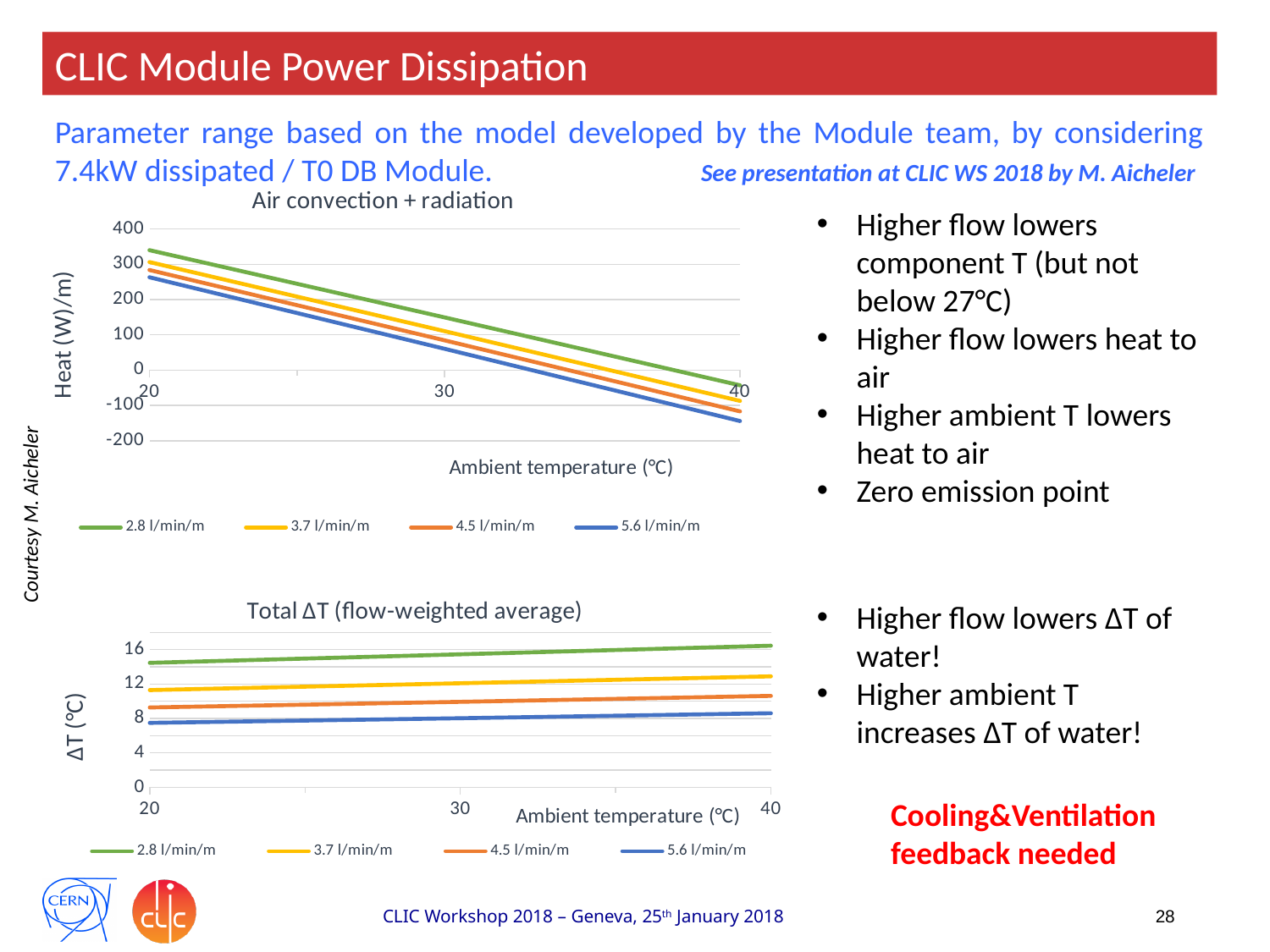
What is the y-axis title of the top chart 'Air convection + radiation'? Heat (W)/m How many series does the legend of the top chart 'Air convection + radiation' list? 4 In the bottom chart 'Total ΔT (flow-weighted average)', is the value for 3.7 l/min/m at 40 °C greater or less than 12? greater In the top chart 'Air convection + radiation', do the values rise or fall as ambient temperature increases from 20 to 40? fall In the top chart 'Air convection + radiation', is the value for 2.8 l/min/m at 20 °C greater or less than 300? greater In the bottom chart 'Total ΔT (flow-weighted average)', do the values rise or fall as ambient temperature increases from 20 to 40? rise In the bottom chart 'Total ΔT (flow-weighted average)', which is larger at 20 °C: the value for 2.8 l/min/m or for 5.6 l/min/m? 2.8 l/min/m What type of chart is the top chart titled 'Air convection + radiation'? line chart What is the title of the bottom chart on the slide? Total ΔT (flow-weighted average) In the top chart 'Air convection + radiation', which series has the lowest value at 20 °C? 5.6 l/min/m In the top chart 'Air convection + radiation', is the value for 5.6 l/min/m at 40 °C greater or less than -100? less In the bottom chart 'Total ΔT (flow-weighted average)', which series has the highest value at 40 °C? 2.8 l/min/m